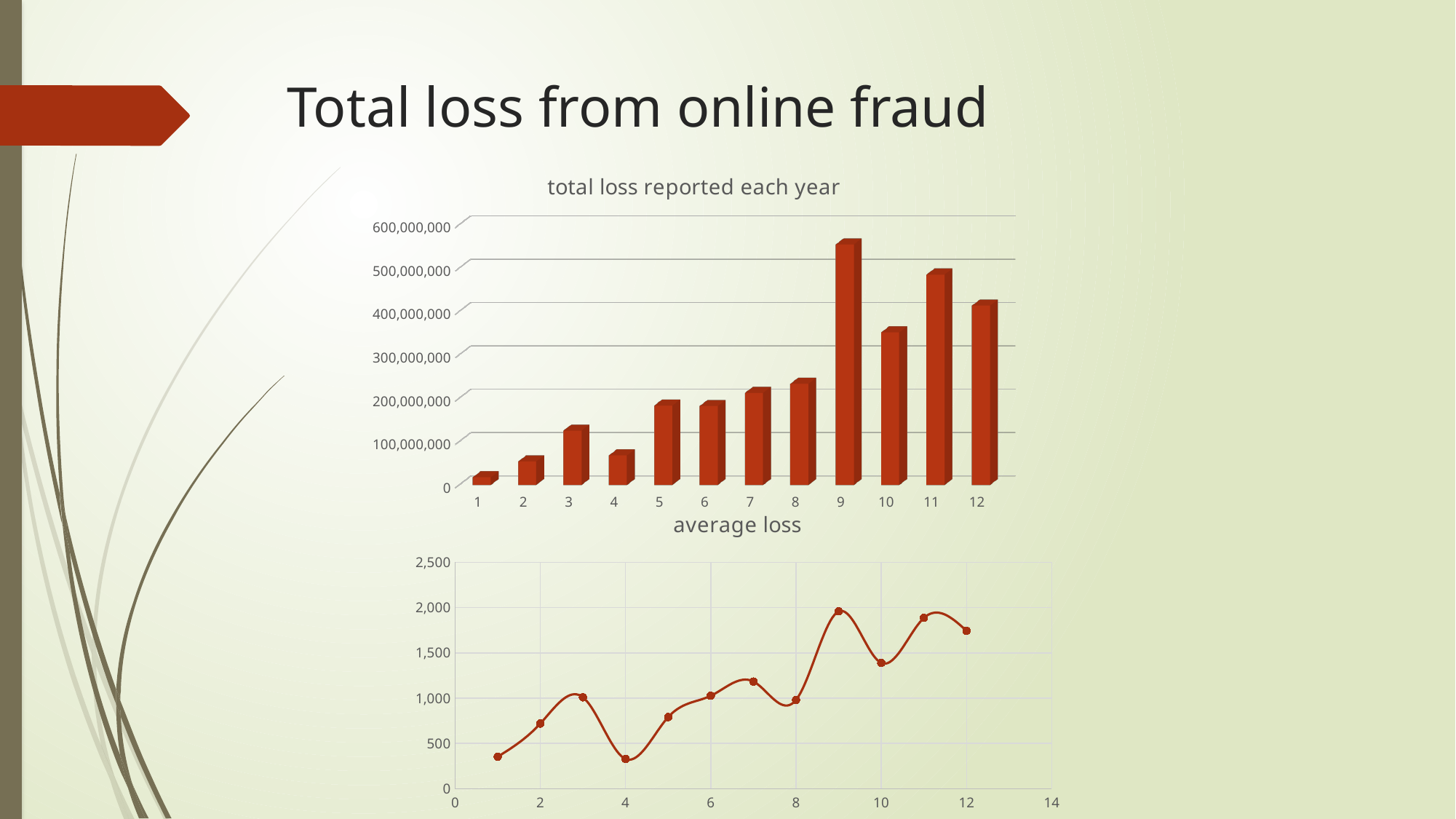
What kind of chart is the bottom chart titled "average loss"? line chart In the bottom chart "average loss", is the value at x = 1 greater or less than 500? less In the top chart "total loss reported each year", which category has the lowest bar? 1 In the top chart "total loss reported each year", which category has the highest bar? 9 In the top chart "total loss reported each year", is the value for category 9 greater or less than 500,000,000? greater In the bottom chart "average loss", how many data points are plotted? 12 In the top chart "total loss reported each year", is the value for category 10 greater or less than 400,000,000? less In the bottom chart "average loss", which is larger, the value at x = 3 or at x = 4? x = 3 In the top chart "total loss reported each year", how many bars are plotted? 12 What kind of chart is the top chart titled "total loss reported each year"? bar chart In the top chart "total loss reported each year", which is larger, the value for category 11 or category 12? 11